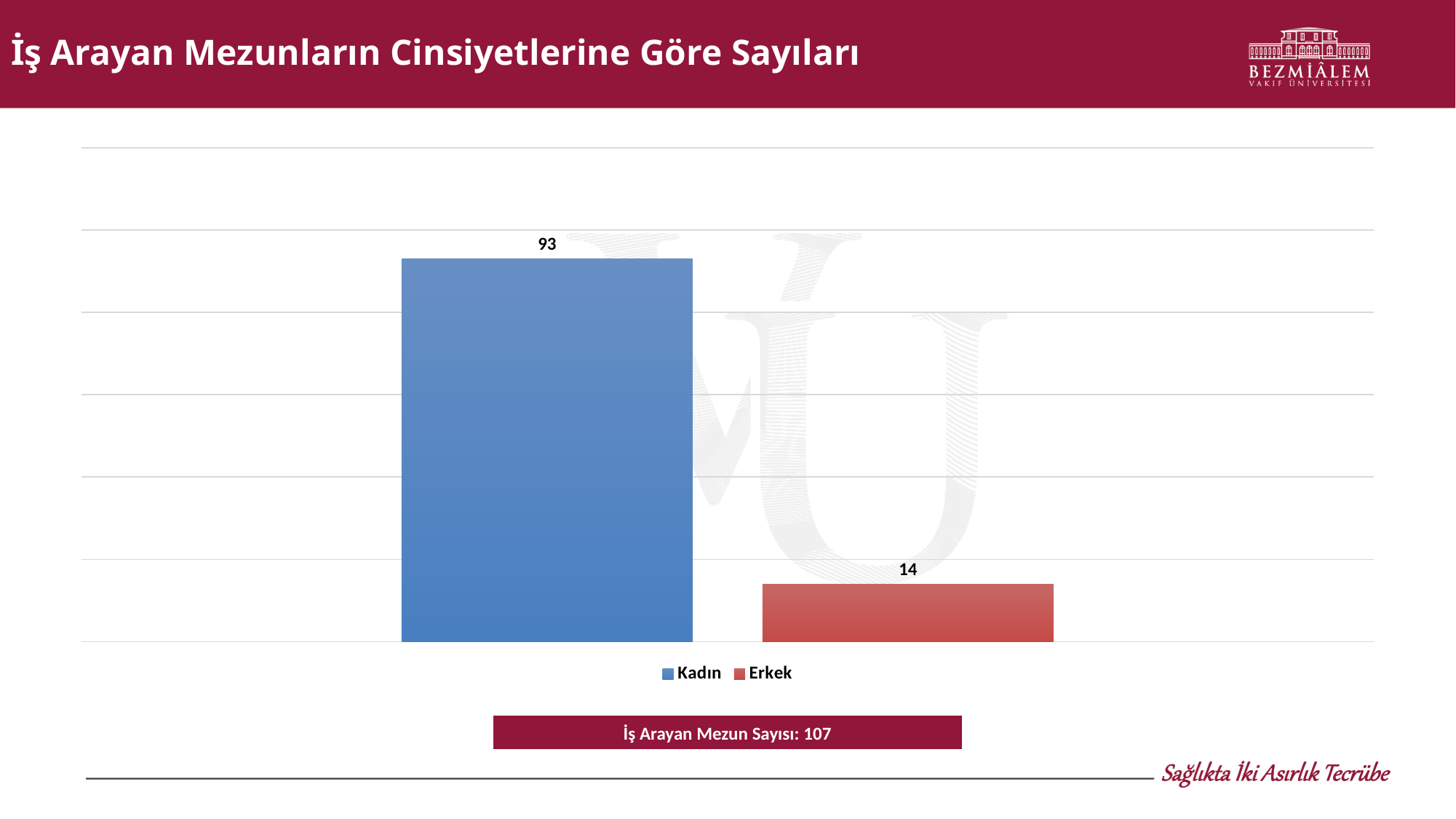
How many categories are shown in the chart? 2 What is the title of the slide? İş Arayan Mezunların Cinsiyetlerine Göre Sayıları How many series does the legend list? 2 Which is larger, the value for Kadın or the value for Erkek? Kadın What is the total of the two values shown in the chart? 107 What kind of chart is shown on the slide? bar chart Which category has the highest value? Kadın What colour is the bar for Kadın? blue Which category has the lowest value? Erkek What is the value for Erkek? 14 What is the value for Kadın? 93 What is the difference between the values for Kadın and Erkek? 79